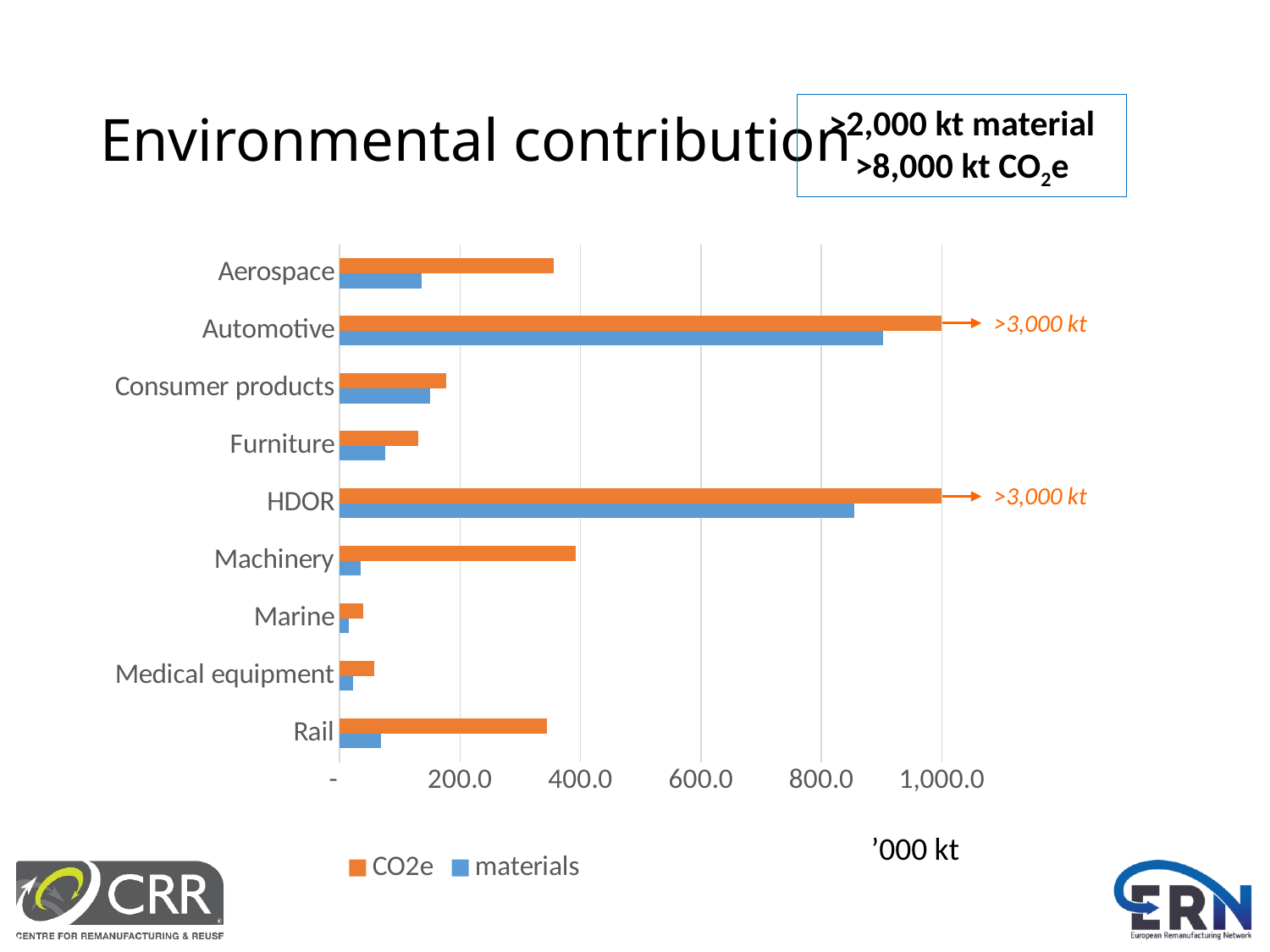
How many categories (sectors) are plotted on the chart? 9 Is the CO2e value for Aerospace greater or less than 400.0? less Is the materials value for HDOR greater or less than 800.0? greater Which category has the lowest CO2e value? Marine How many series does the legend list? 2 Is the materials value for Machinery greater or less than 200.0? less Which is larger, the CO2e value for Machinery or the CO2e value for Aerospace? Machinery Which two series are listed in the chart legend? CO2e and materials What unit is shown below the x axis of the chart? '000 kt What kind of chart is shown on the slide? bar chart Which is larger, the CO2e value for Consumer products or the CO2e value for Furniture? Consumer products